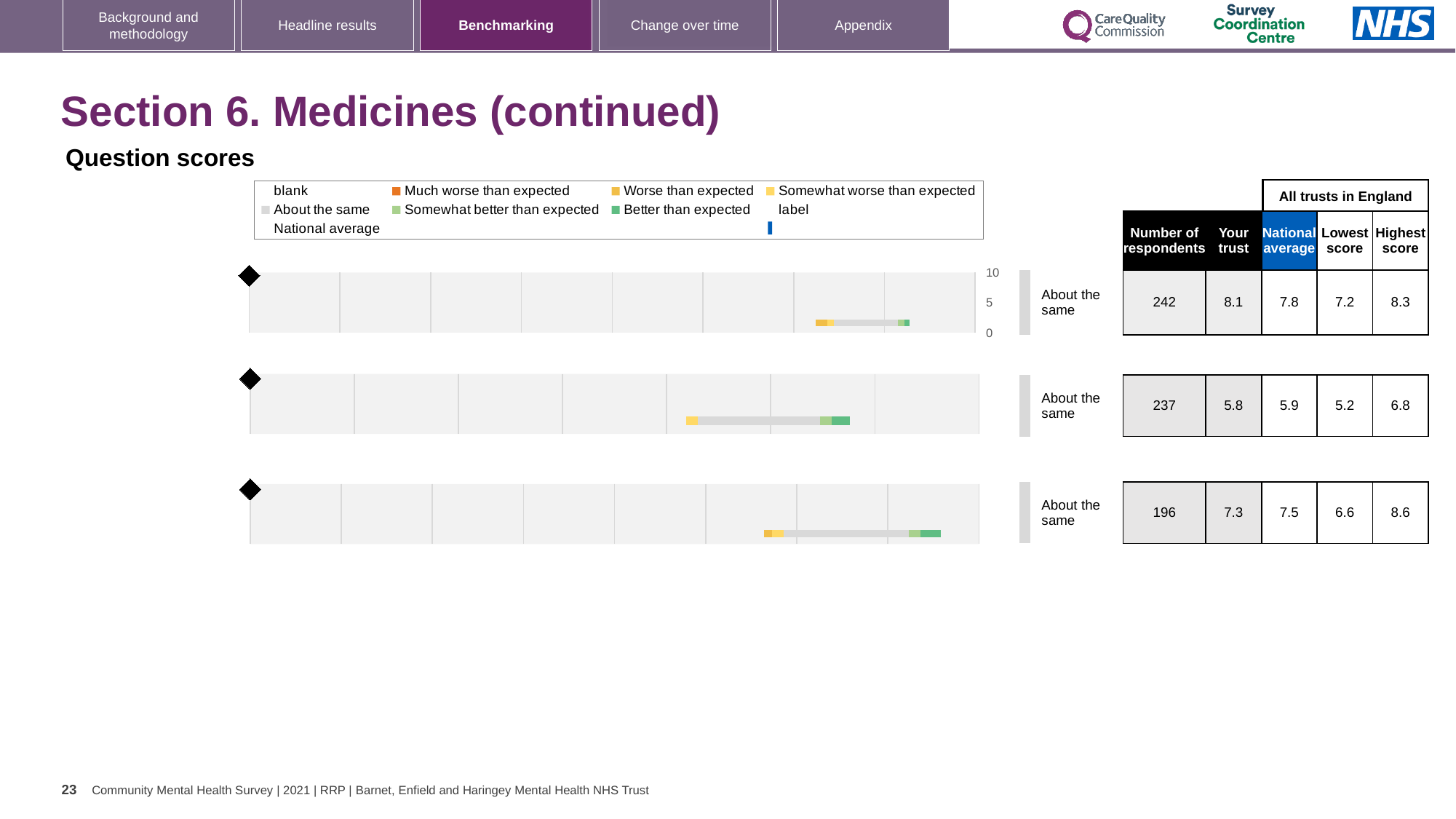
For the bottom chart, which is larger: the 'Your trust' score or the national average? National average For the top chart, what is the difference between the 'Your trust' score and the national average? 0.3 For the middle chart, what is the national average score? 5.9 Which chart (top, middle or bottom) has the highest 'Your trust' score? Top chart For the bottom chart, what is the highest score among all trusts in England? 8.6 For the top chart, what is the number of respondents? 242 How many question score charts are shown on the slide? 3 Which chart (top, middle or bottom) has the fewest respondents? Bottom chart For the top chart, what is the 'Your trust' score? 8.1 What benchmark category is shown next to the middle chart? About the same What kind of chart is used for the question scores on this slide? bar chart For the middle chart, what is the lowest score among all trusts in England? 5.2